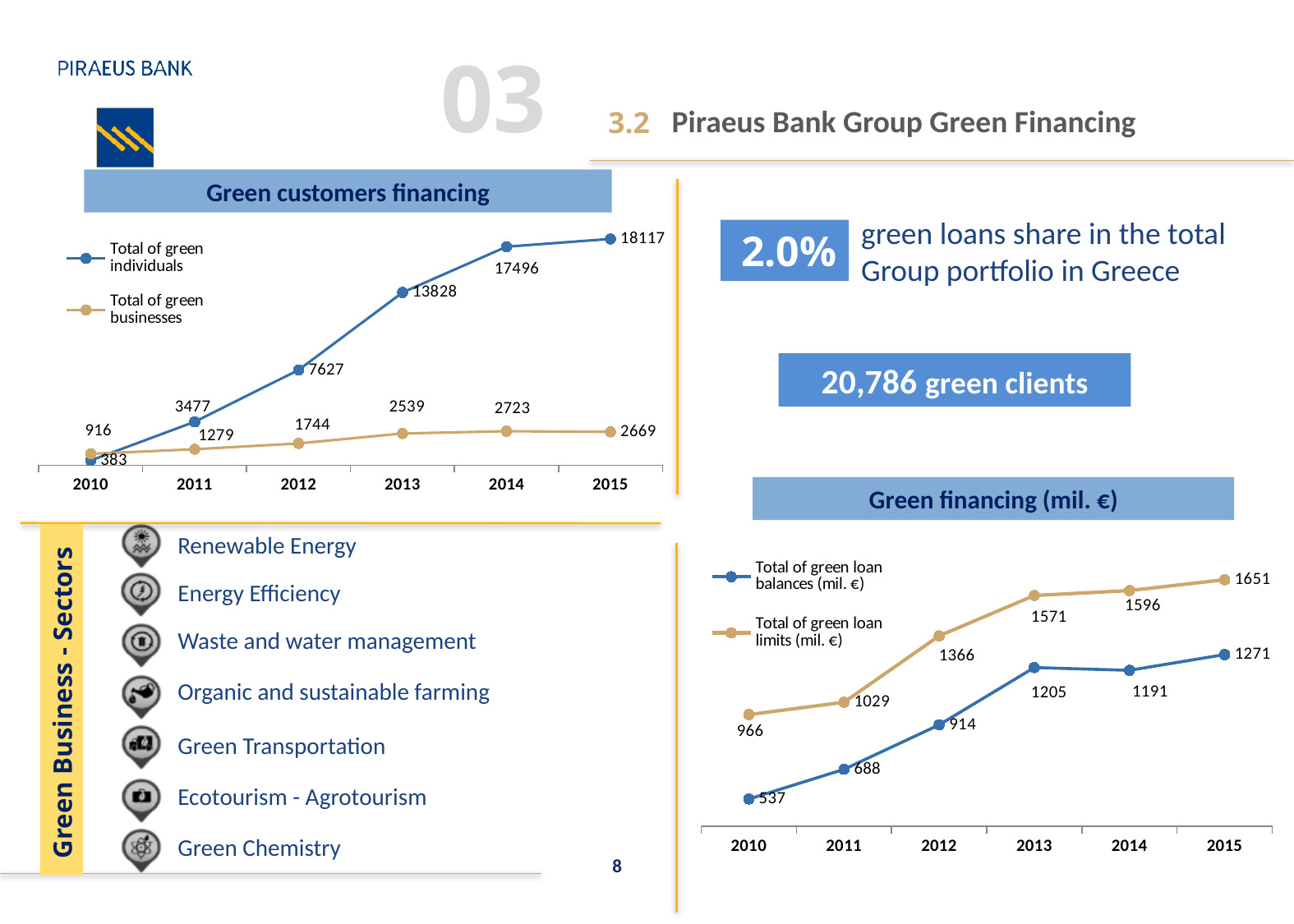
In the 'Green financing (mil. €)' chart, what is the difference between Total of green loan limits and Total of green loan balances in 2015? 380 In the 'Green customers financing' chart, what is the difference between Total of green individuals and Total of green businesses in 2012? 5883 In the 'Green financing (mil. €)' chart, what is the value for Total of green loan limits in 2012? 1366 In the 'Green customers financing' chart, what is the value for Total of green businesses in 2013? 2539 In the 'Green customers financing' chart, which year has the highest value for Total of green businesses? 2014 In the 'Green customers financing' chart, what is the value for Total of green individuals in 2015? 18117 In the 'Green financing (mil. €)' chart, what is the value for Total of green loan balances in 2010? 537 In the 'Green financing (mil. €)' chart, which year has the lowest value for Total of green loan balances? 2010 In the 'Green financing (mil. €)' chart, how many years are shown on the x axis? 6 What kind of chart is the 'Green customers financing' chart? Line chart In the 'Green customers financing' chart, how many series does the legend list? 2 In the 'Green financing (mil. €)' chart, does Total of green loan limits generally rise or fall from 2010 to 2015? Rise